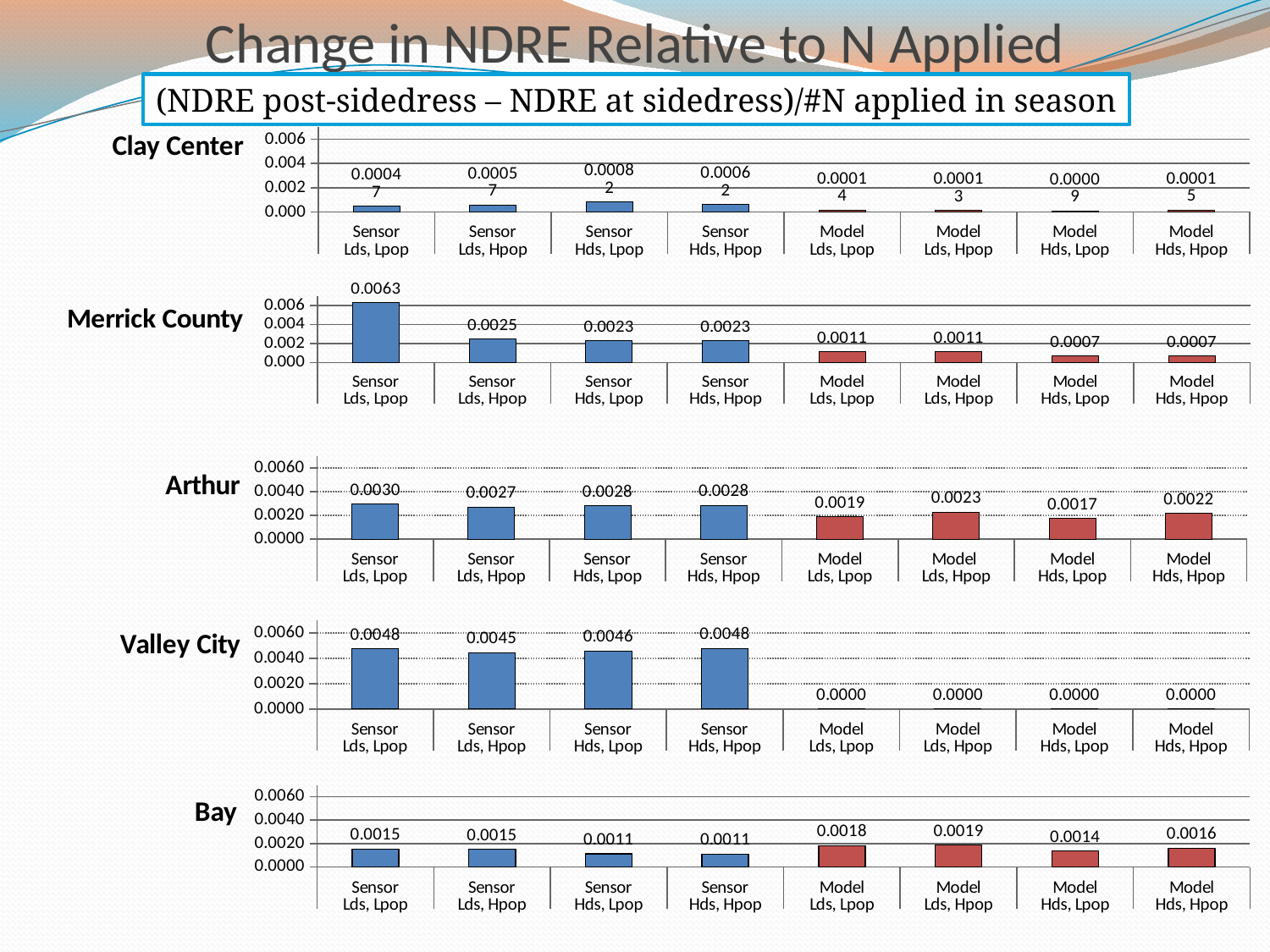
How many categories are shown in the Valley City chart? 8 In the Valley City chart, what is the value for Model Lds, Lpop? 0.0000 In the Arthur chart, what is the value for Model Lds, Hpop? 0.0023 In the Merrick County chart, which category has the highest value? Sensor Lds, Lpop In the Merrick County chart, what is the difference between Sensor Lds, Lpop and Sensor Lds, Hpop? 0.0038 In the Bay chart, what is the value for Sensor Hds, Lpop? 0.0011 In the Clay Center chart, which category has the highest value? Sensor Hds, Lpop In the Arthur chart, which category has the lowest value? Model Hds, Lpop In the Merrick County chart, what is the value for Sensor Lds, Lpop? 0.0063 In the Bay chart, which is larger: Model Lds, Lpop or Sensor Lds, Lpop? Model Lds, Lpop In the Merrick County chart, is the value for Sensor Lds, Lpop greater or less than 0.004? greater What kind of chart is the Bay chart? bar chart